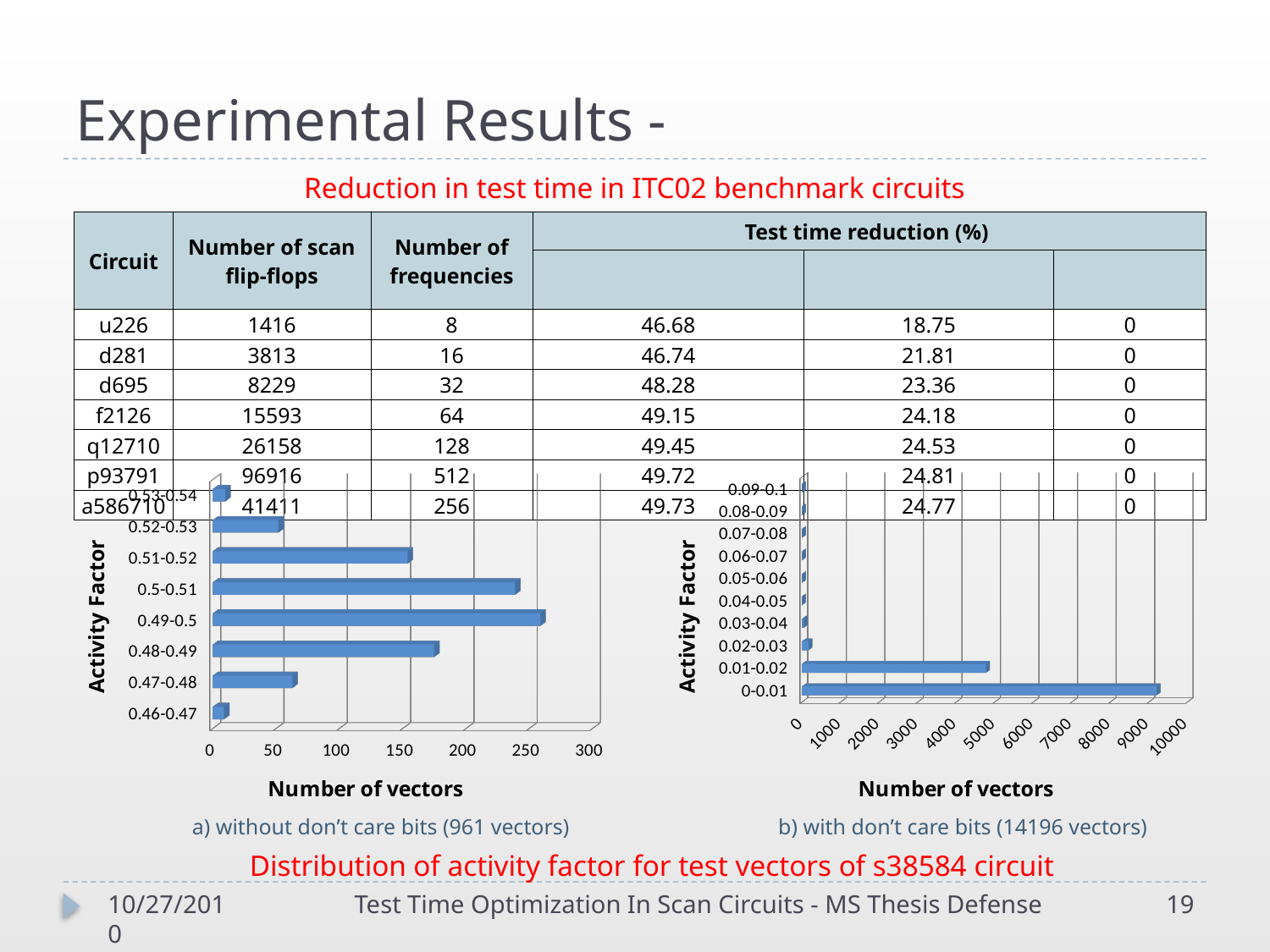
In the left chart (a, without don't care bits), which activity factor range has the highest number of vectors? 0.49-0.5 In the right chart (b, with don't care bits), how many activity factor categories are shown? 10 In the right chart (b, with don't care bits), is the number of vectors for 0-0.01 greater or less than 9000? greater In the right chart (b, with don't care bits), which activity factor range has the highest number of vectors? 0-0.01 In the left chart (a, without don't care bits), how many activity factor categories are shown? 8 In the right chart (b, with don't care bits), is the number of vectors for 0.01-0.02 greater or less than 4000? greater What is the x-axis title of the right chart (b, with don't care bits)? Number of vectors What kind of chart is the left chart, a) without don't care bits? bar chart In the left chart (a, without don't care bits), is the number of vectors for 0.5-0.51 greater or less than 200? greater In the left chart (a, without don't care bits), which has more vectors: 0.48-0.49 or 0.47-0.48? 0.48-0.49